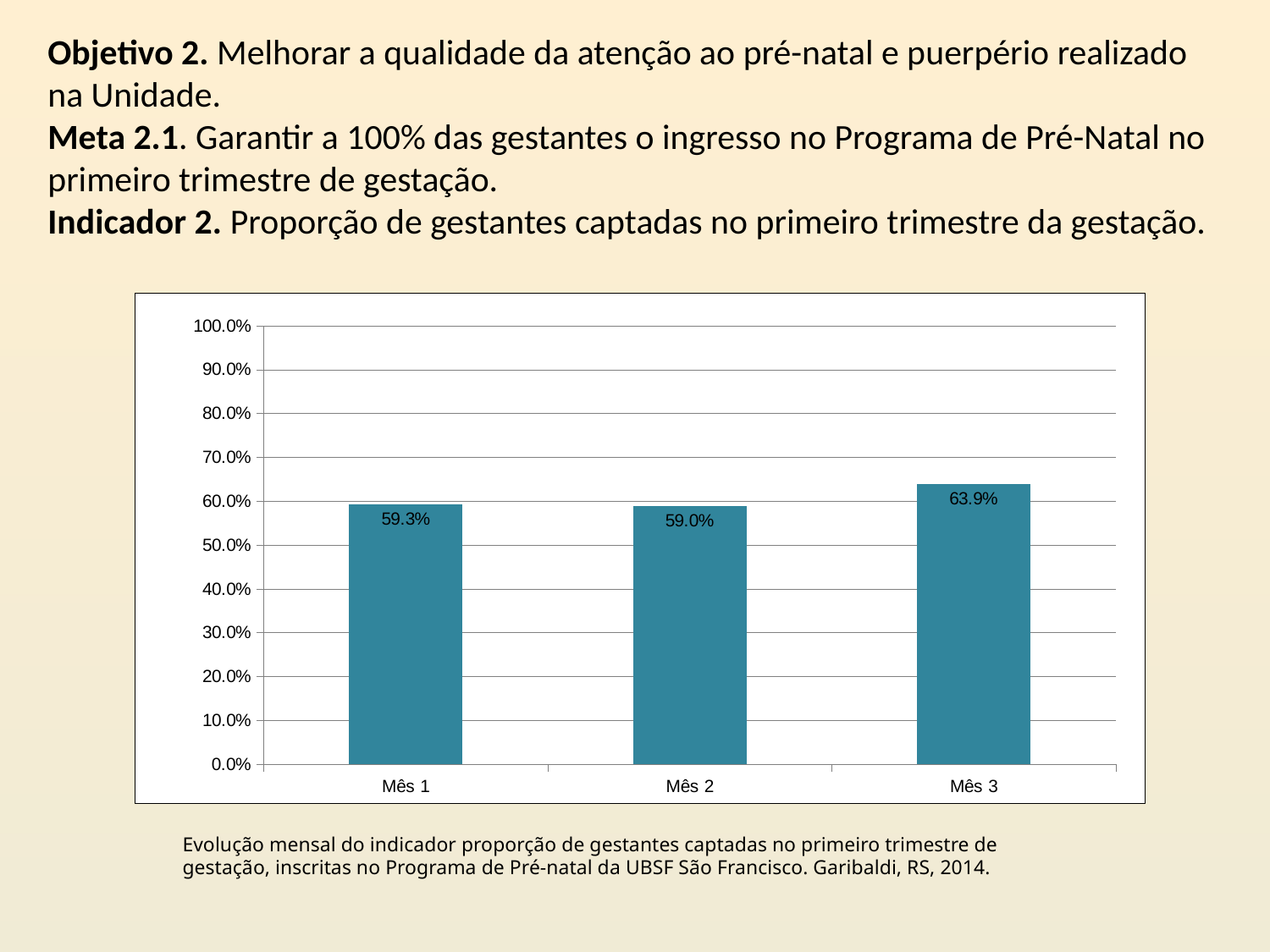
What is the highest value shown on the y axis? 100.0% Is the value for Mês 3 greater or less than 60.0%? greater What kind of chart is shown on the slide? bar chart What is the difference between the values for Mês 3 and Mês 1? 4.6% Which month has the highest value? Mês 3 What is the difference between the values for Mês 1 and Mês 2? 0.3% How many months are shown on the x axis? 3 What is the value for Mês 2? 59.0% What is the value for Mês 1? 59.3% Which month has the lowest value? Mês 2 What is the value for Mês 3? 63.9% Which is larger, the value for Mês 3 or the value for Mês 2? Mês 3